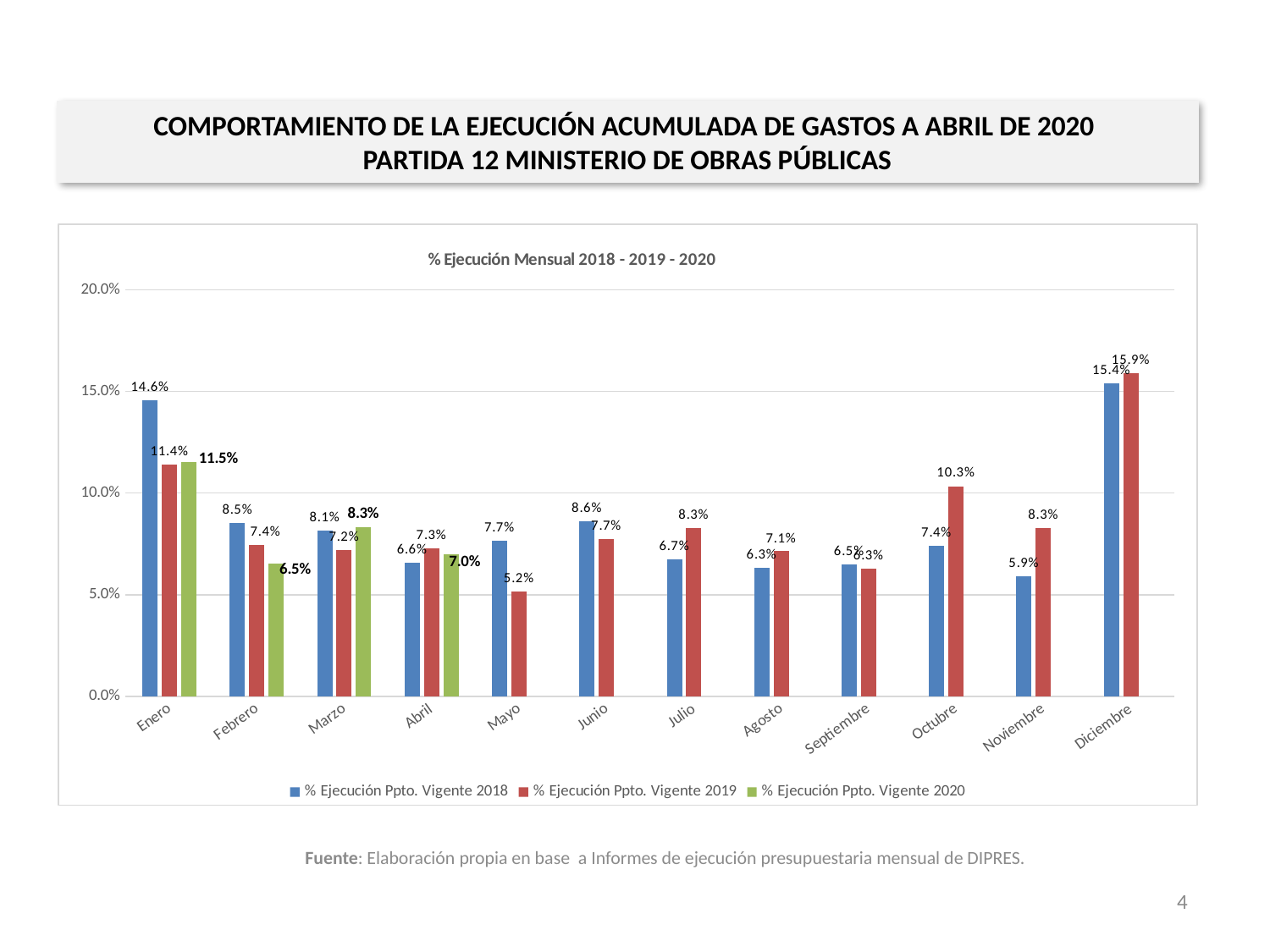
Which is larger in Abril: the 2019 value or the 2020 value? 2019 What is the title of the chart? % Ejecución Mensual 2018 - 2019 - 2020 What is the value for % Ejecución Ppto. Vigente 2018 in Enero? 14.6% What type of chart is shown on the slide? bar chart What is the difference between the 2018 and 2019 values in Enero? 3.2% What is the value for % Ejecución Ppto. Vigente 2019 in Octubre? 10.3% What is the value for % Ejecución Ppto. Vigente 2020 in Marzo? 8.3% How many months are shown on the x axis? 12 How many series does the legend list? 3 Which month has the highest value for % Ejecución Ppto. Vigente 2019? Diciembre Which month has the lowest value for % Ejecución Ppto. Vigente 2018? Noviembre Is the value for % Ejecución Ppto. Vigente 2019 in Mayo greater or less than 10.0%? less